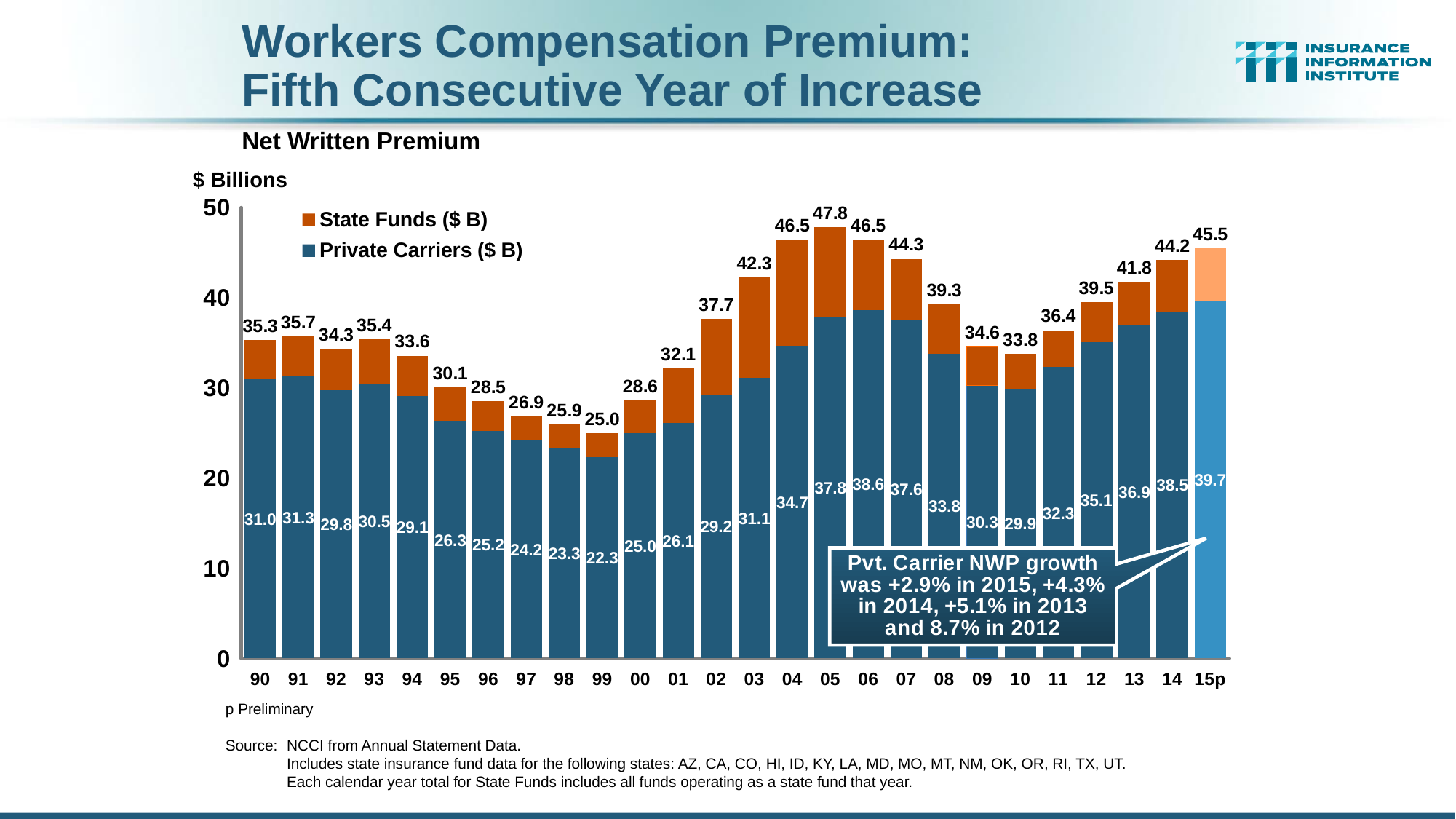
What is the State Funds portion for 15p, given the total and Private Carriers values shown? 5.8 Do the total net written premium values rise or fall from 05 to 10? Fall Which year has the highest total net written premium? 05 What was the Private Carriers value for 15p? 39.7 What is the difference between the total for 14 and the total for 13? 2.4 What was the total net written premium in 2005? 47.8 What kind of chart is shown on the slide? Stacked bar chart Which year has the lowest total net written premium? 99 How many series does the legend list? 2 What was the Private Carriers value in 1990? 31.0 Which year had a larger total net written premium, 03 or 07? 07 How many years are shown on the x axis? 26